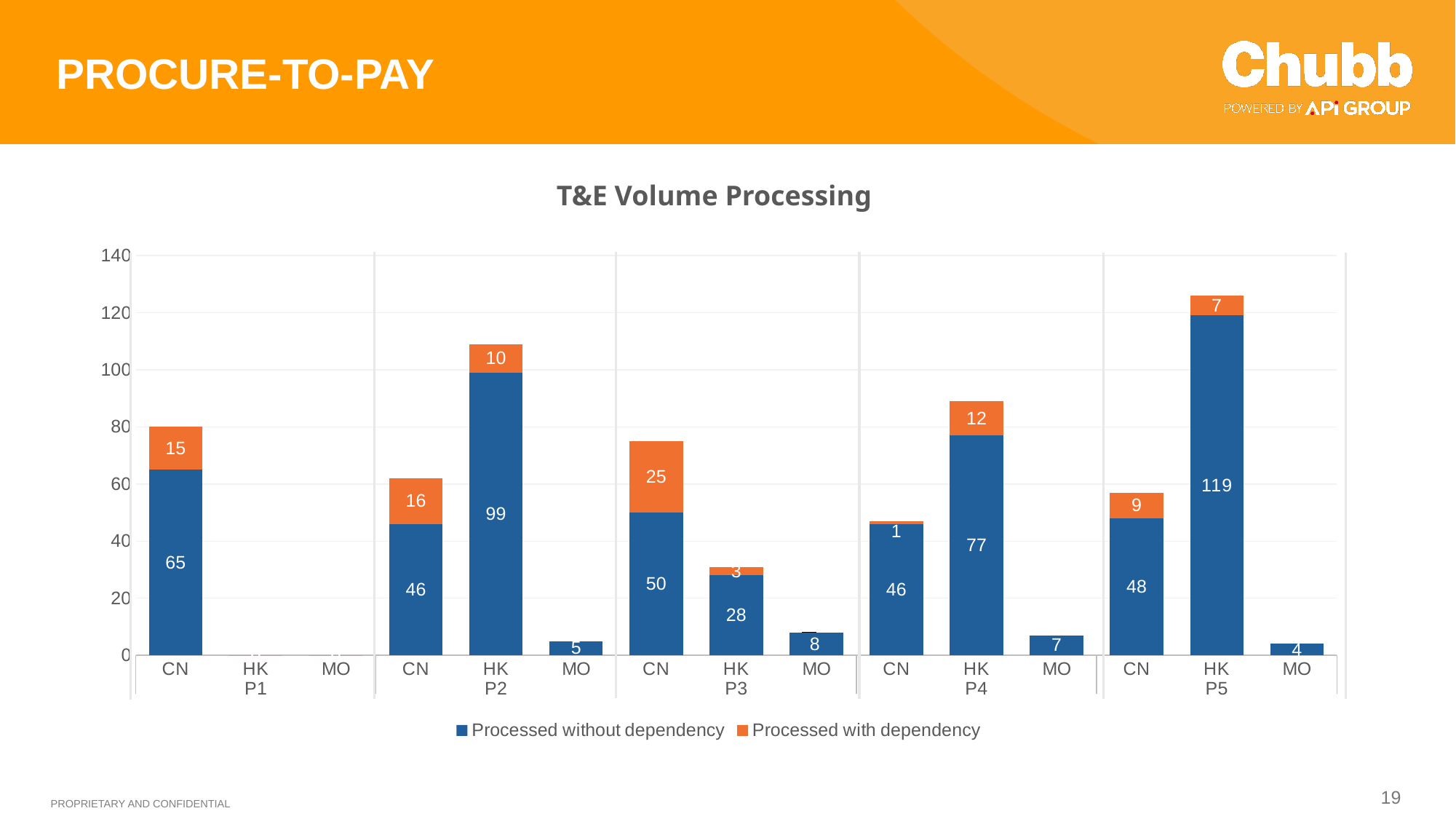
Which has the larger 'Processed with dependency' value, CN in P2 or CN in P3? CN in P3 What is the 'Processed with dependency' value for CN in P3? 25 Which bar has the lowest labelled 'Processed with dependency' value? CN in P4 What is the 'Processed without dependency' value for HK in P5? 119 What is the difference between the 'Processed without dependency' values for HK in P2 and HK in P4? 22 What is the total of the stacked bar for HK in P2? 109 Which bar has the highest 'Processed without dependency' value? HK in P5 How many series does the legend list? 2 What is the 'Processed without dependency' value for MO in P3? 8 Is the total of the stacked bar for HK in P5 greater or less than 120? greater What is the total of the stacked bar for CN in P1? 80 What kind of chart is shown on the slide? Stacked bar chart